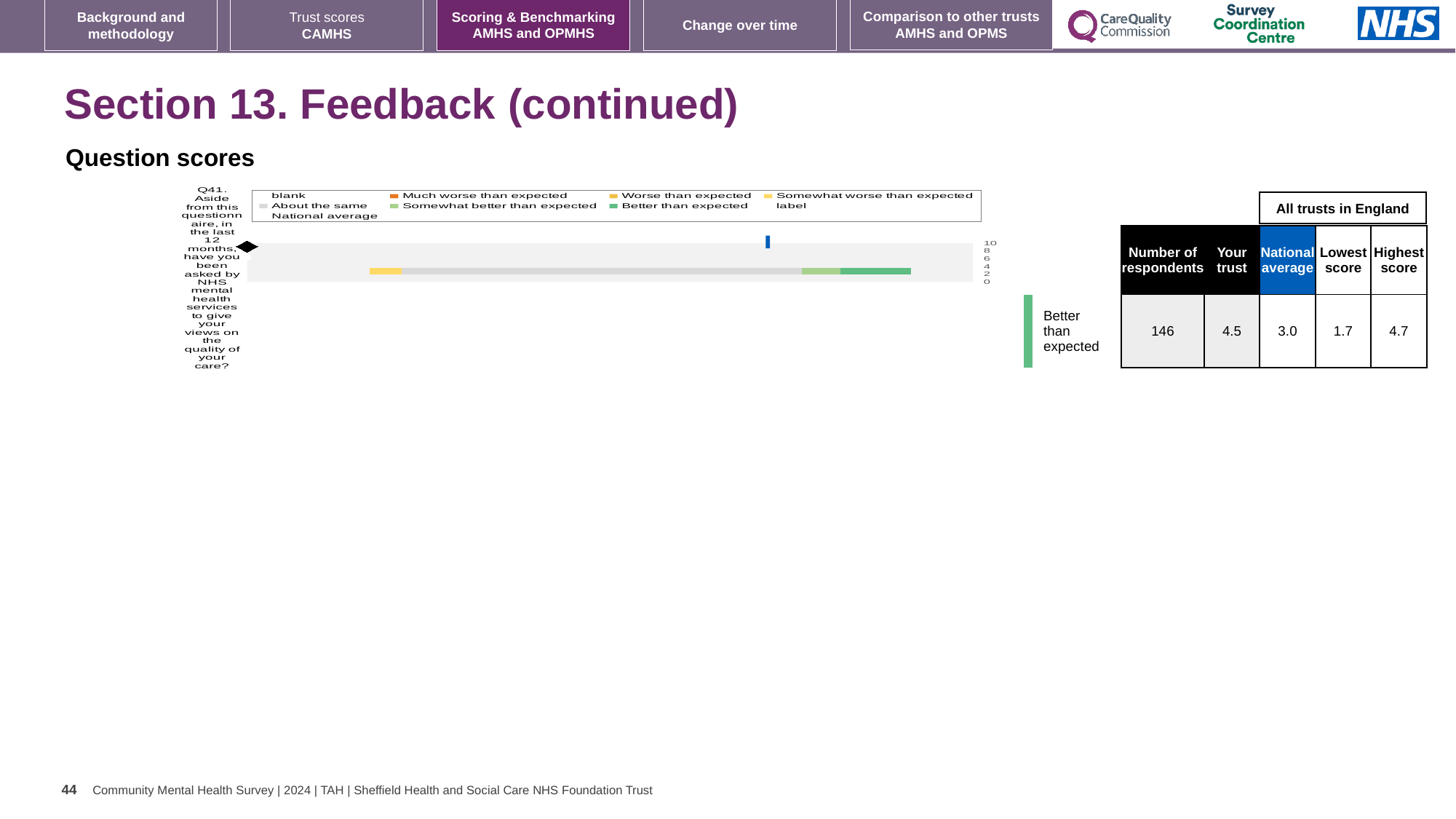
Is the national average marker on the Q41 bar greater or less than 2? greater In the table beside the Q41 chart, what is the number of respondents? 146 In the table beside the Q41 chart, what is the national average score? 3.0 Which question number is plotted in the chart on the slide? Q41 In the table beside the Q41 chart, which is larger: the 'Your trust' score or the national average? Your trust What is the highest value shown on the chart's axis? 10 In the table beside the Q41 chart, what is the lowest score among all trusts in England? 1.7 What rating is given to the trust's score for Q41 next to the chart? Better than expected What kind of chart is shown for Q41 on the slide? bar chart In the table beside the Q41 chart, what is the 'Your trust' score? 4.5 How many questions (categories) are plotted in the chart on the slide? 1